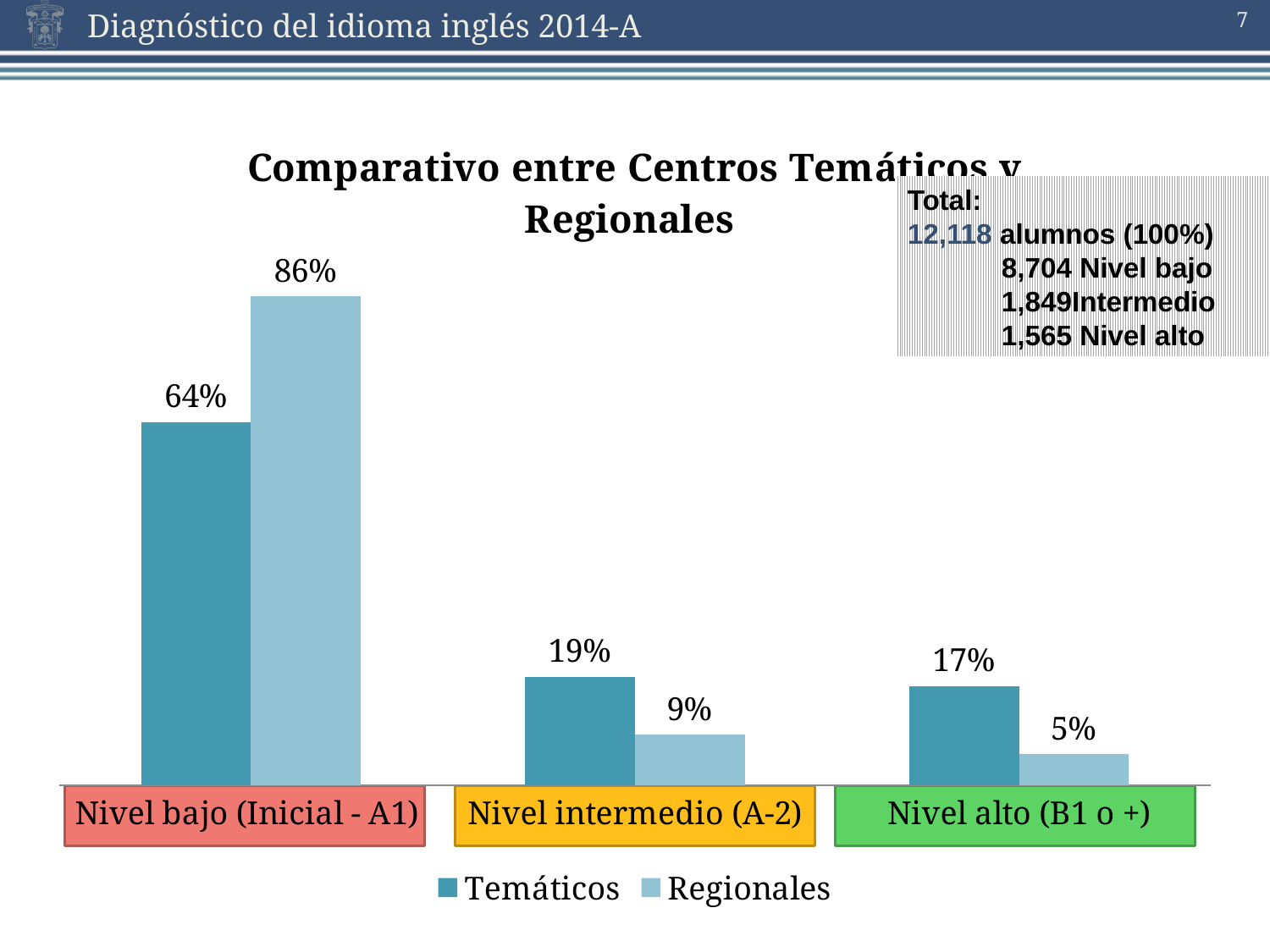
What kind of chart is shown on the slide? Bar chart What is the value for Regionales in the Nivel alto (B1 o +) category? 5% What is the value for Temáticos in the Nivel bajo (Inicial - A1) category? 64% In the Nivel intermedio (A-2) category, which series has the larger value, Temáticos or Regionales? Temáticos What is the value for Regionales in the Nivel bajo (Inicial - A1) category? 86% How many series does the legend list? 2 What is the value for Temáticos in the Nivel intermedio (A-2) category? 19% Which series is shown in the lighter blue colour? Regionales What is the difference between the Regionales and Temáticos values in the Nivel bajo (Inicial - A1) category? 22% Which category has the highest value for Regionales? Nivel bajo (Inicial - A1) How many categories are shown on the x axis? 3 Which category has the lowest value for Temáticos? Nivel alto (B1 o +)